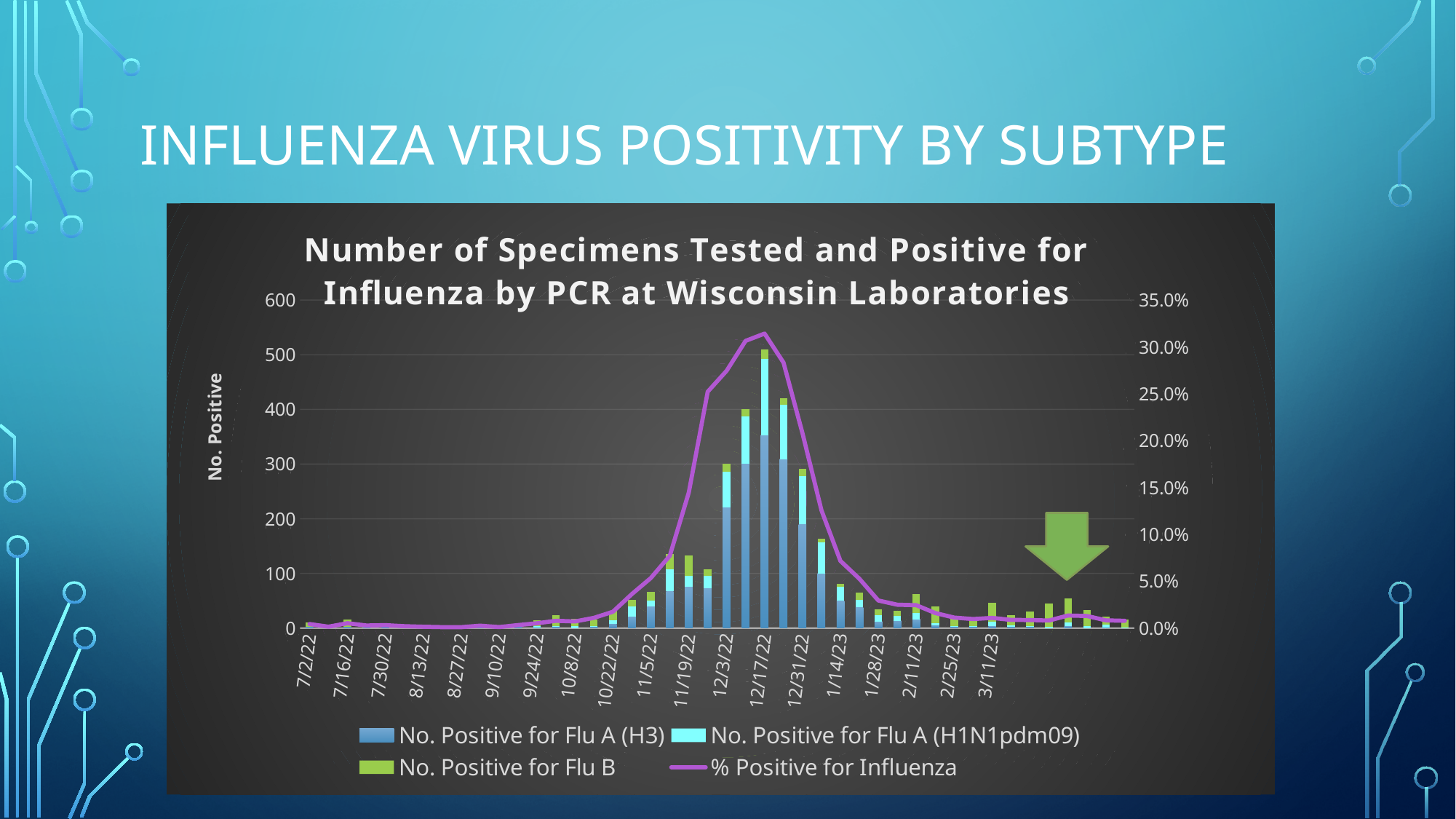
Which series is plotted as the purple line? % Positive for Influenza Is the total of the tallest stacked bar (around 12/17/22) greater or less than 400? greater What kind of chart is shown on the slide? A combined bar and line chart (stacked bars with a line) How many series does the legend list? 4 Around which date label does the stacked bar reach its highest value? 12/17/22 What is the highest tick value shown on the right-hand percentage axis? 35.0% Do the stacked bar totals rise or fall from 10/22/22 to 12/17/22? rise Is the peak value of the % Positive for Influenza line greater or less than 30.0%? greater Do the stacked bar totals rise or fall from 12/17/22 to 3/11/23? fall Which has the larger stacked bar total, 12/3/22 or 12/17/22? 12/17/22 What is the title of the chart? Number of Specimens Tested and Positive for Influenza by PCR at Wisconsin Laboratories Is the stacked bar total at 7/2/22 greater or less than 100? less